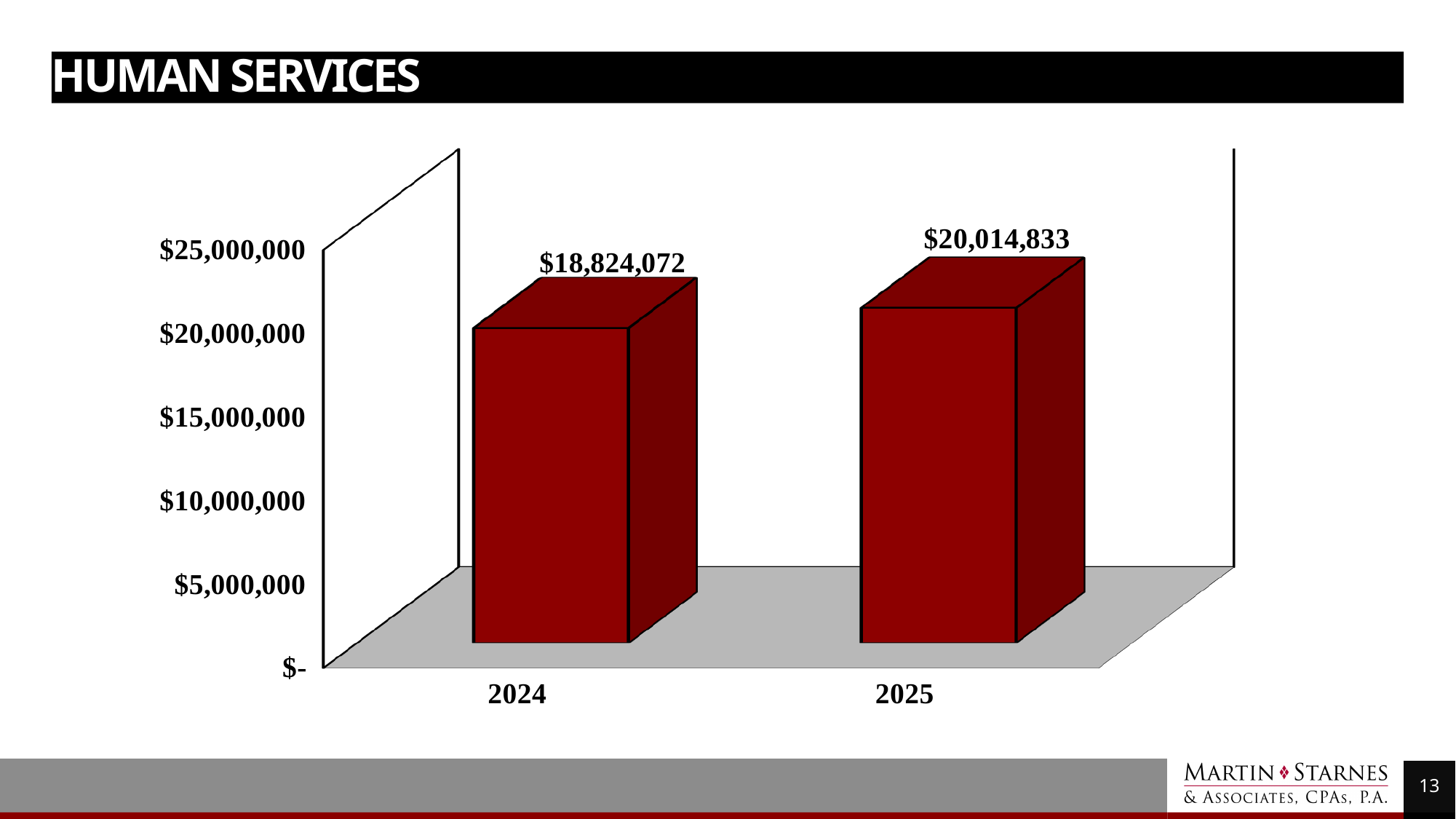
Which year has the higher value? 2025 What is the value for 2024? $18,824,072 What is the value for 2025? $20,014,833 Is the value for 2025 greater or less than $15,000,000? greater What kind of chart is shown on the slide? Bar chart What is the difference between the 2025 and 2024 values? $1,190,761 What is the title of the slide? HUMAN SERVICES Do the values rise or fall from 2024 to 2025? Rise How many years are shown on the chart? 2 Is the value for 2025 larger than the value for 2024? Yes Which year has the lower value? 2024 Is the value for 2024 greater or less than $20,000,000? less